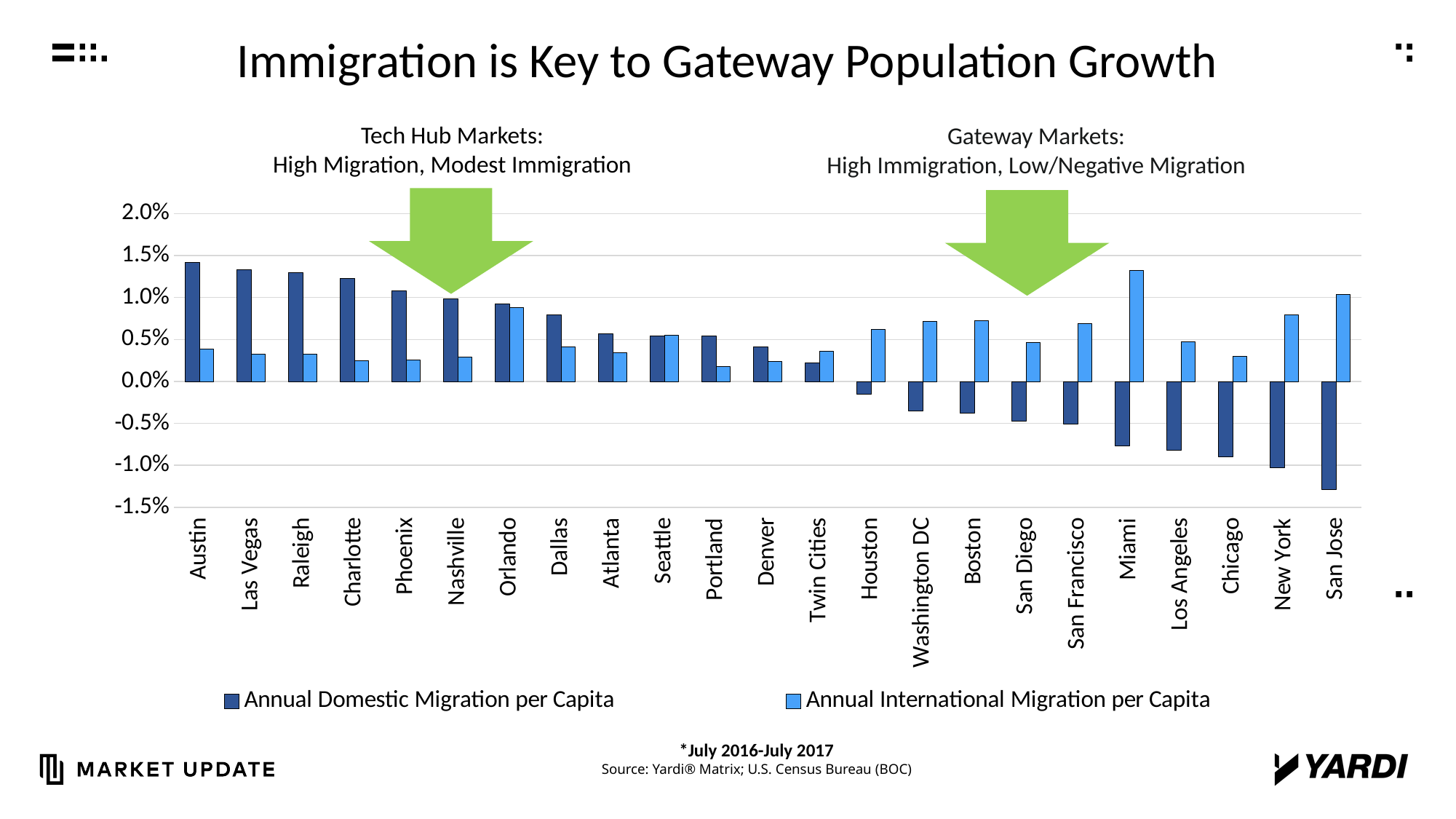
Which market has the highest Annual International Migration per Capita? Miami Which market has the lowest Annual Domestic Migration per Capita? San Jose Does Annual Domestic Migration per Capita generally rise or fall moving from Austin on the left to San Jose on the right? fall How many markets are shown along the x axis? 23 Is the Annual Domestic Migration per Capita for Chicago greater or less than -0.5%? less What kind of chart is shown on the slide? bar chart What is the title of the chart on the slide? Immigration is Key to Gateway Population Growth Is the Annual International Migration per Capita for Miami greater or less than 1.0%? greater Which market has the highest Annual Domestic Migration per Capita? Austin How many series does the legend list? 2 For Boston, which is larger: Annual Domestic Migration per Capita or Annual International Migration per Capita? Annual International Migration per Capita Is the Annual Domestic Migration per Capita for Austin greater or less than 1.0%? greater